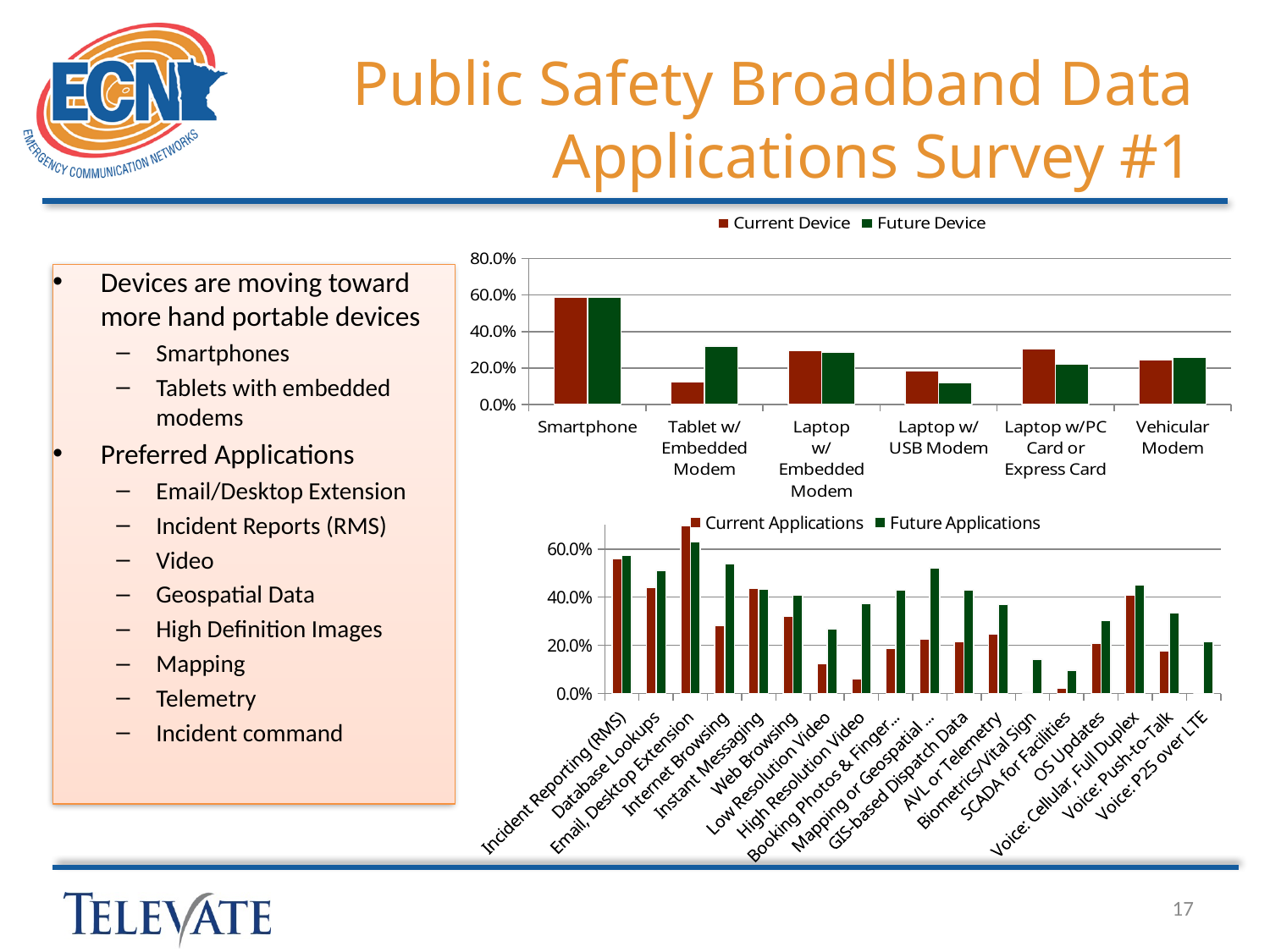
In the top chart (devices), how many device categories are shown on the x axis? 6 In the top chart (devices), which category has the highest Current Device value? Smartphone What type of chart is the top chart on the slide (the one with the 'Current Device' and 'Future Device' legend)? Bar chart In the top chart (devices), for Laptop w/ USB Modem, which is larger: Current Device or Future Device? Current Device In the bottom chart (applications), which category has the highest Current Applications value? Email, Desktop Extension In the top chart (devices), is the Future Device value for Tablet w/ Embedded Modem greater or less than 20.0%? greater In the top chart (devices), for Tablet w/ Embedded Modem, which is larger: Current Device or Future Device? Future Device In the bottom chart (applications), is the Future Applications value for Internet Browsing greater or less than 40.0%? greater In the top chart (devices), how many series does the legend list? 2 In the bottom chart (applications), how many application categories are shown on the x axis? 18 In the top chart (devices), which category has the lowest Future Device value? Laptop w/ USB Modem In the bottom chart (applications), what are the two legend entries? Current Applications and Future Applications